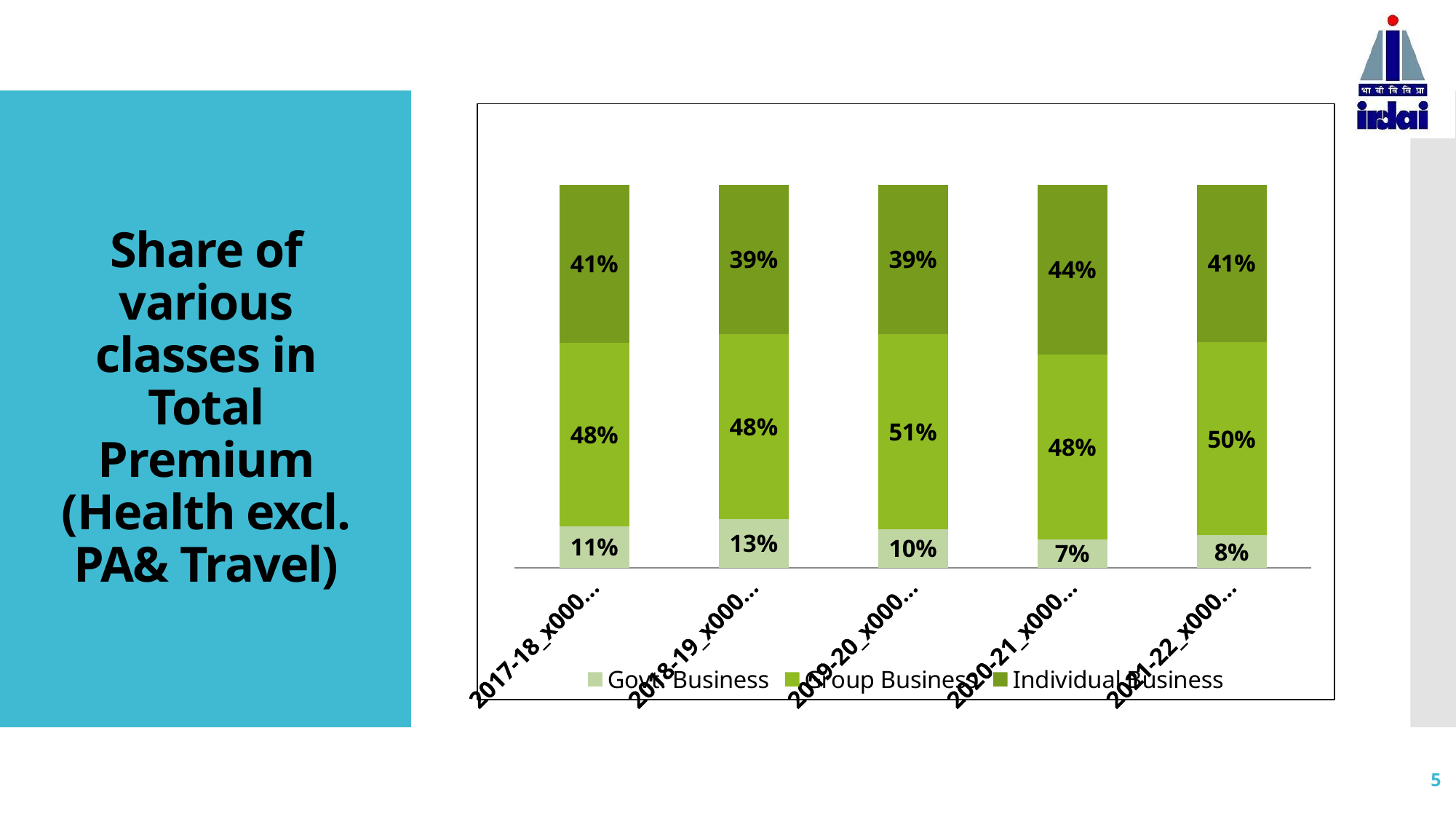
Does the Govt Business share rise or fall from 2018-19 to 2020-21? Fall What is the share of Individual Business in 2020-21? 44% How many series does the legend list? 3 Which is larger in 2017-18, the Group Business share or the Individual Business share? Group Business In which year is the Individual Business share highest? 2020-21 What is the difference between the Group Business share and the Govt Business share in 2021-22? 42% In which year is the Govt Business share lowest? 2020-21 Which series is shown in the darkest green at the top of each bar? Individual Business How many year categories are plotted on the x axis? 5 What kind of chart is shown on the slide? Stacked bar chart What is the share of Group Business in 2019-20? 51% What is the share of Govt Business in 2018-19? 13%